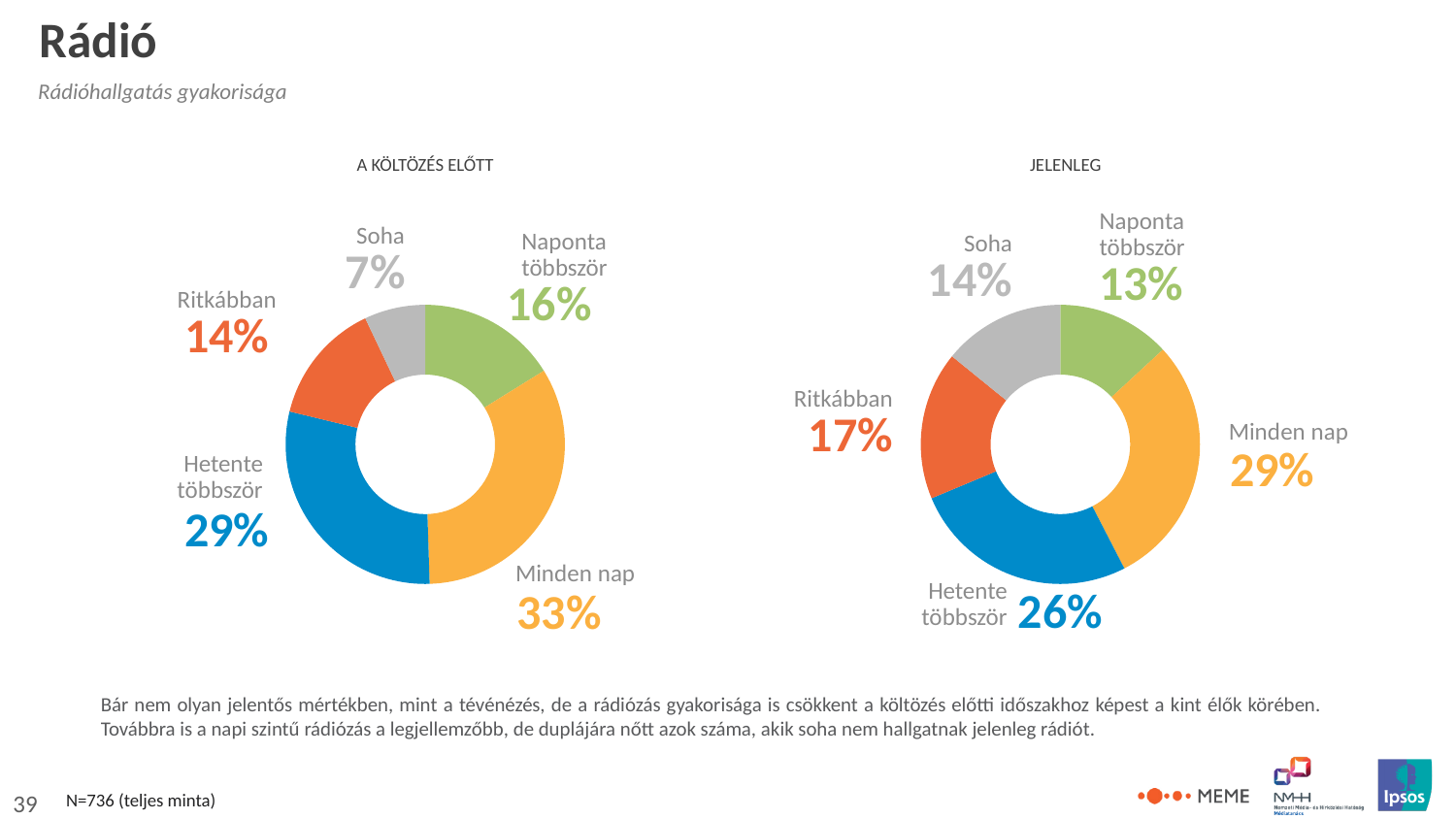
In the "JELENLEG" chart, which is larger: "Ritkábban" or "Naponta többször"? Ritkábban In the "A KÖLTÖZÉS ELŐTT" chart, which category has the smallest share? Soha What kind of chart is the "A KÖLTÖZÉS ELŐTT" chart? Doughnut chart In the "A KÖLTÖZÉS ELŐTT" chart, what is the difference between "Minden nap" and "Hetente többször"? 4 percentage points In the "JELENLEG" chart, which category has the largest share? Minden nap In the "JELENLEG" chart, what is the difference between "Soha" and "Naponta többször"? 1 percentage point In the "JELENLEG" chart, what is the value for "Hetente többször"? 26% What colour is the "Hetente többször" segment in the "A KÖLTÖZÉS ELŐTT" chart? Blue In the "A KÖLTÖZÉS ELŐTT" chart, what is the value for "Naponta többször"? 16% How many categories does the "JELENLEG" chart show? 5 In the "JELENLEG" chart, what is the value for "Soha"? 14% In the "A KÖLTÖZÉS ELŐTT" chart, what is the value for "Minden nap"? 33%